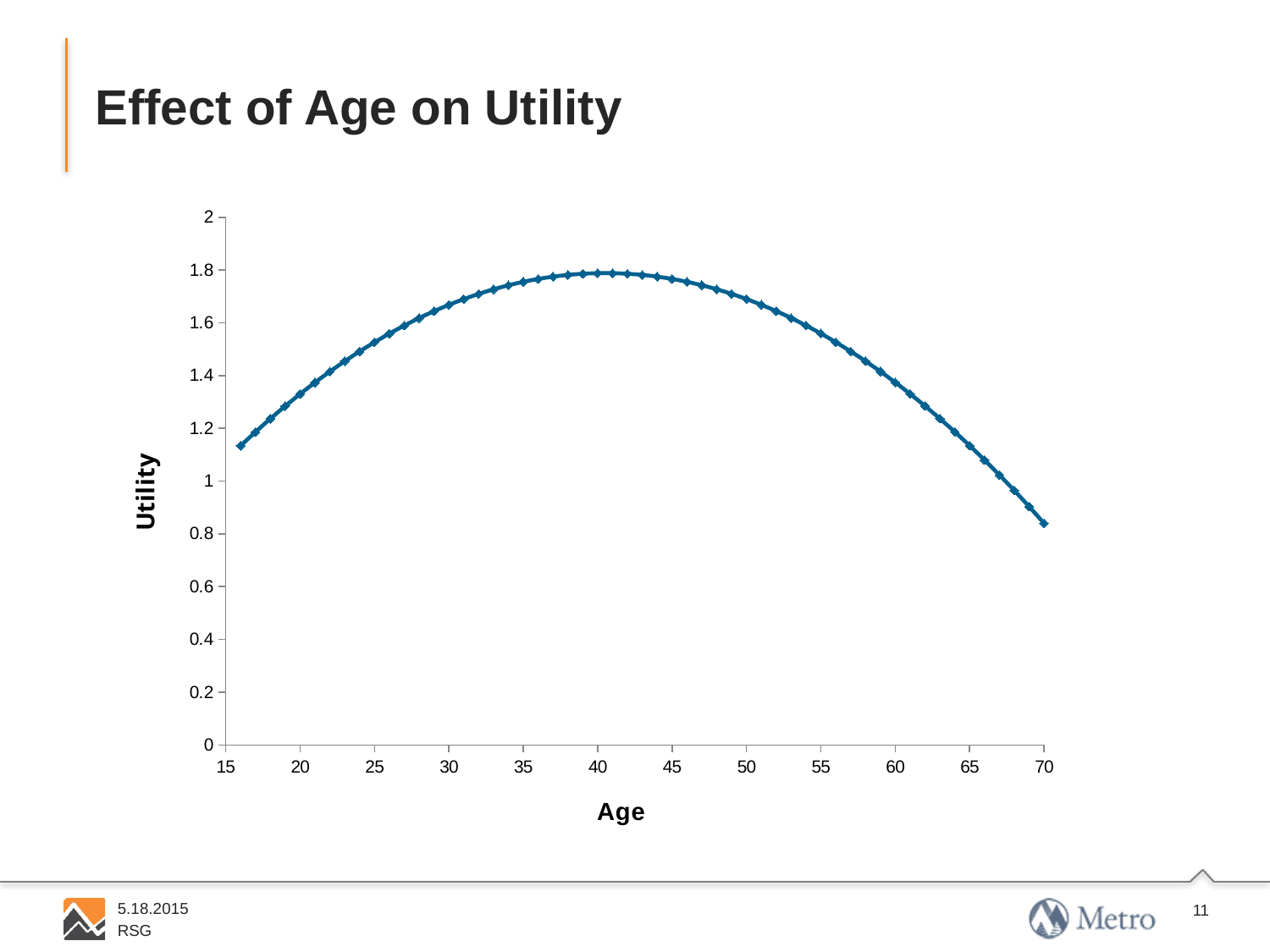
Is the utility value at age 65 greater or less than 1.4? less Does utility rise or fall as age increases from 50 to 70? fall Is the utility value at age 60 greater or less than 1.6? less Is the utility value at age 70 greater or less than 1? less What is the title of the chart? Effect of Age on Utility At which plotted age is utility lowest? 70 What is the label on the vertical axis? Utility Which age has a higher utility, 20 or 65? 20 Does utility rise or fall as age increases from 15 to 35? rise What kind of chart is shown on the slide? line chart